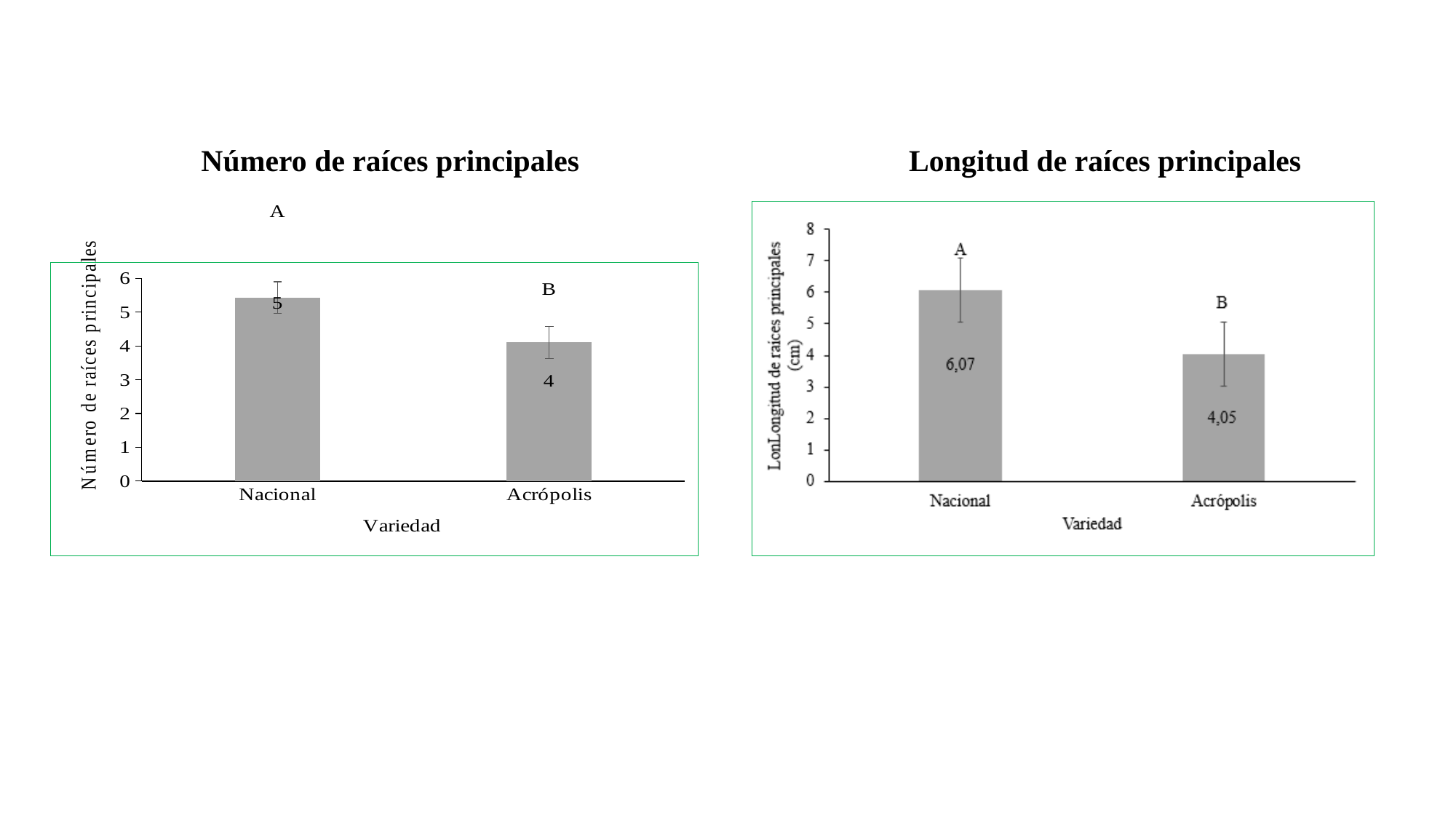
In the chart titled "Longitud de raíces principales", is the value for Nacional greater or less than 5? greater In the chart titled "Número de raíces principales", what data label is shown on the Nacional bar? 5 In the chart titled "Longitud de raíces principales", what is the value for Acrópolis? 4,05 In the chart titled "Longitud de raíces principales", how many varieties are shown on the x axis? 2 In the chart titled "Número de raíces principales", which variety has the lowest value? Acrópolis What kind of chart is the chart titled "Número de raíces principales"? Bar chart In the chart titled "Número de raíces principales", what data label is shown on the Acrópolis bar? 4 What is the x-axis title of the chart titled "Longitud de raíces principales"? Variedad In the chart titled "Número de raíces principales", is the value for Nacional or Acrópolis larger? Nacional In the chart titled "Longitud de raíces principales", what is the difference between the values for Nacional and Acrópolis? 2,02 In the chart titled "Longitud de raíces principales", what is the value for Nacional? 6,07 In the chart titled "Longitud de raíces principales", which variety has the highest value? Nacional